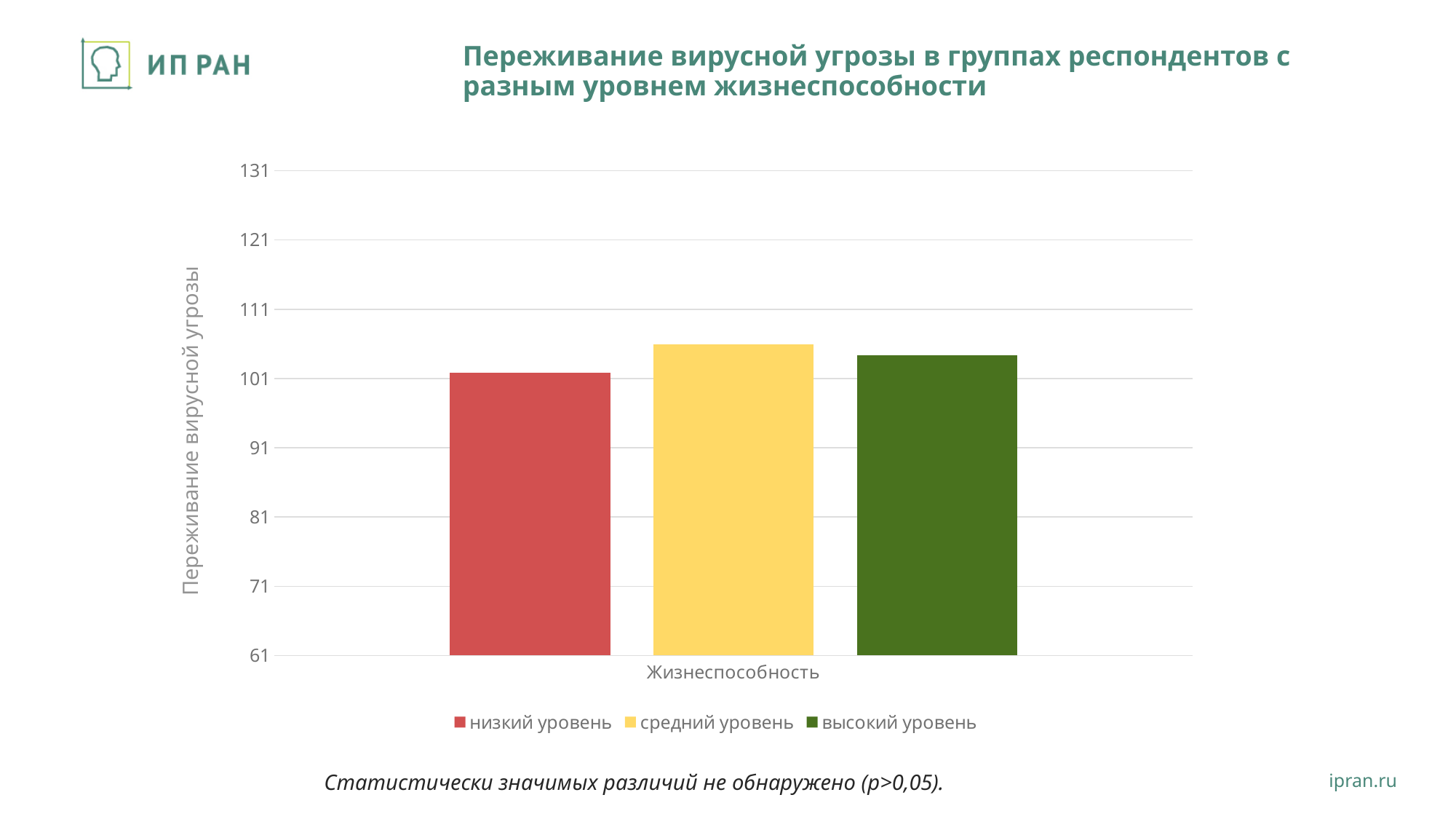
What is the label on the vertical axis of the chart? Переживание вирусной угрозы Is the value for низкий уровень greater or less than 91? greater Which group has the highest value for Переживание вирусной угрозы? средний уровень Is the value for высокий уровень greater or less than 111? less Which is larger, the value for низкий уровень or the value for средний уровень? средний уровень What kind of chart is shown on the slide? bar chart What colour is the bar for средний уровень? yellow Is the value for средний уровень greater or less than 101? greater How many series does the legend list? 3 Which group has the lowest value for Переживание вирусной угрозы? низкий уровень Which is larger, the value for низкий уровень or the value for высокий уровень? высокий уровень How many bars are plotted in the chart? 3